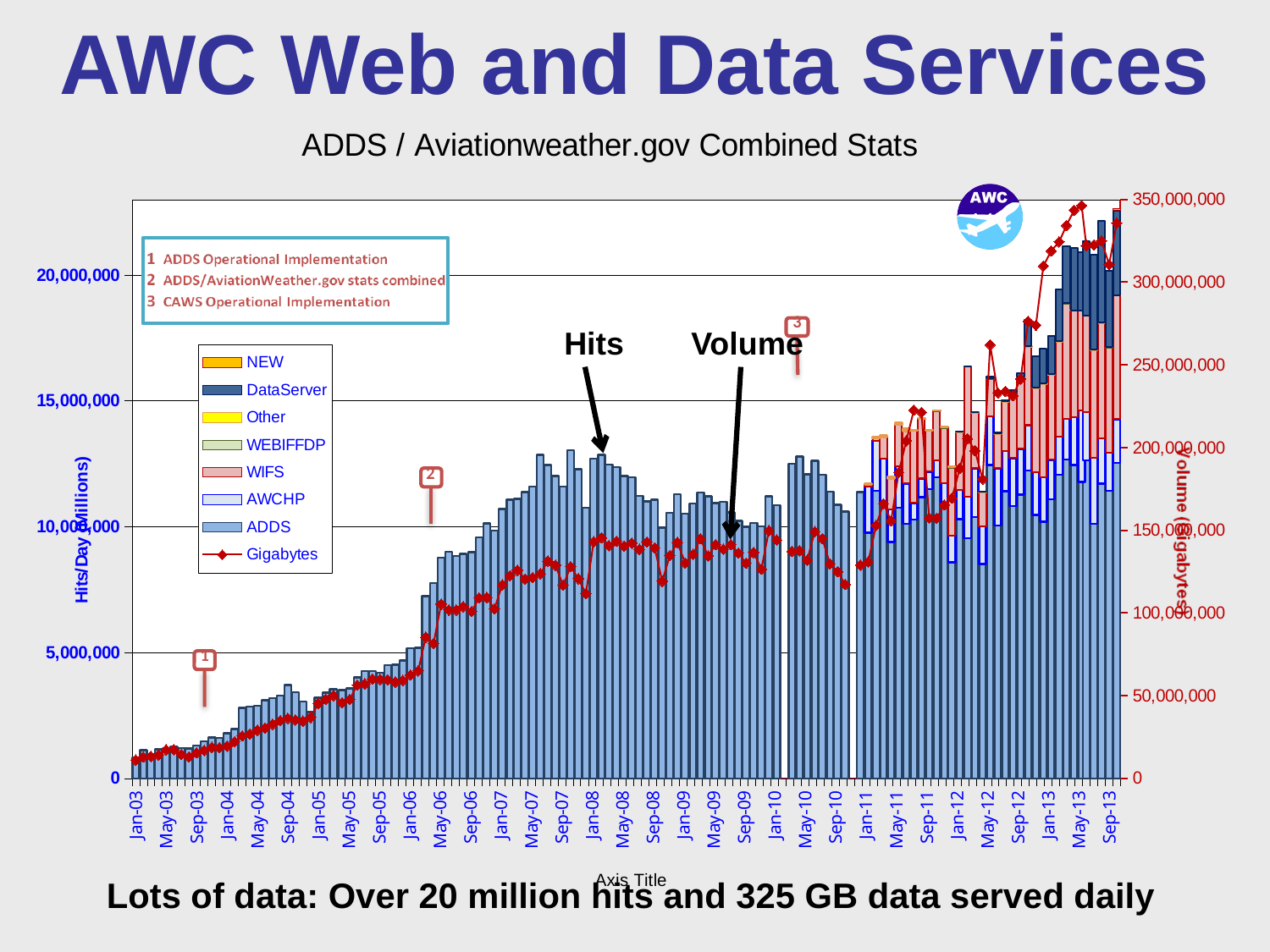
Is the Gigabytes value for Jan-03 greater or less than 50,000,000? less Which series in the legend is plotted as a line with diamond markers? Gigabytes What is the title of the left vertical axis? Hits/Day (Millions) Is the total hits value for Jan-08 greater or less than 15,000,000? less Which is larger, the total hits value for Jan-03 or for Sep-13? Sep-13 How many series does the chart legend list? 8 What kind of chart is shown on the slide? A combined stacked bar and line chart Is the total hits value for Jan-03 greater or less than 5,000,000? less Overall, do the Gigabytes values rise or fall from Jan-03 to Sep-13? rise